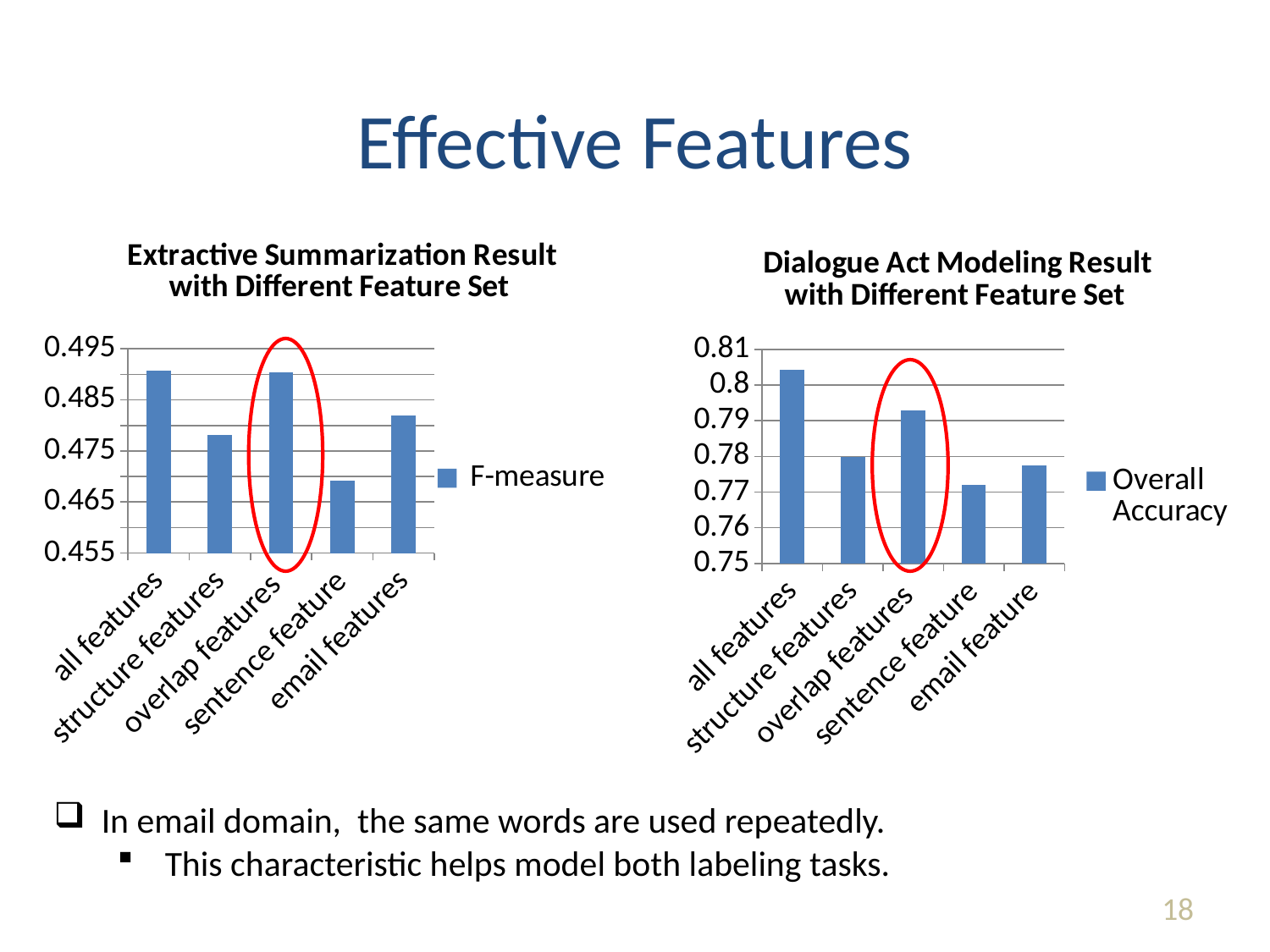
In the "Dialogue Act Modeling Result with Different Feature Set" chart, is the Overall Accuracy for all features greater or less than 0.8? greater In the "Dialogue Act Modeling Result with Different Feature Set" chart, which has the higher Overall Accuracy: structure features or overlap features? overlap features How many series does the legend of the "Extractive Summarization Result with Different Feature Set" chart list? 1 In the "Extractive Summarization Result with Different Feature Set" chart, is the F-measure for sentence feature greater or less than 0.475? less What is the name of the series in the legend of the "Dialogue Act Modeling Result with Different Feature Set" chart? Overall Accuracy In the "Extractive Summarization Result with Different Feature Set" chart, is the F-measure for email features greater or less than 0.475? greater In the "Extractive Summarization Result with Different Feature Set" chart, which category has the lowest F-measure? sentence feature What type of chart is the "Extractive Summarization Result with Different Feature Set" chart? bar chart In the "Dialogue Act Modeling Result with Different Feature Set" chart, which category has the highest Overall Accuracy? all features In the "Dialogue Act Modeling Result with Different Feature Set" chart, which category has the lowest Overall Accuracy? sentence feature How many categories are shown on the x axis of the "Dialogue Act Modeling Result with Different Feature Set" chart? 5